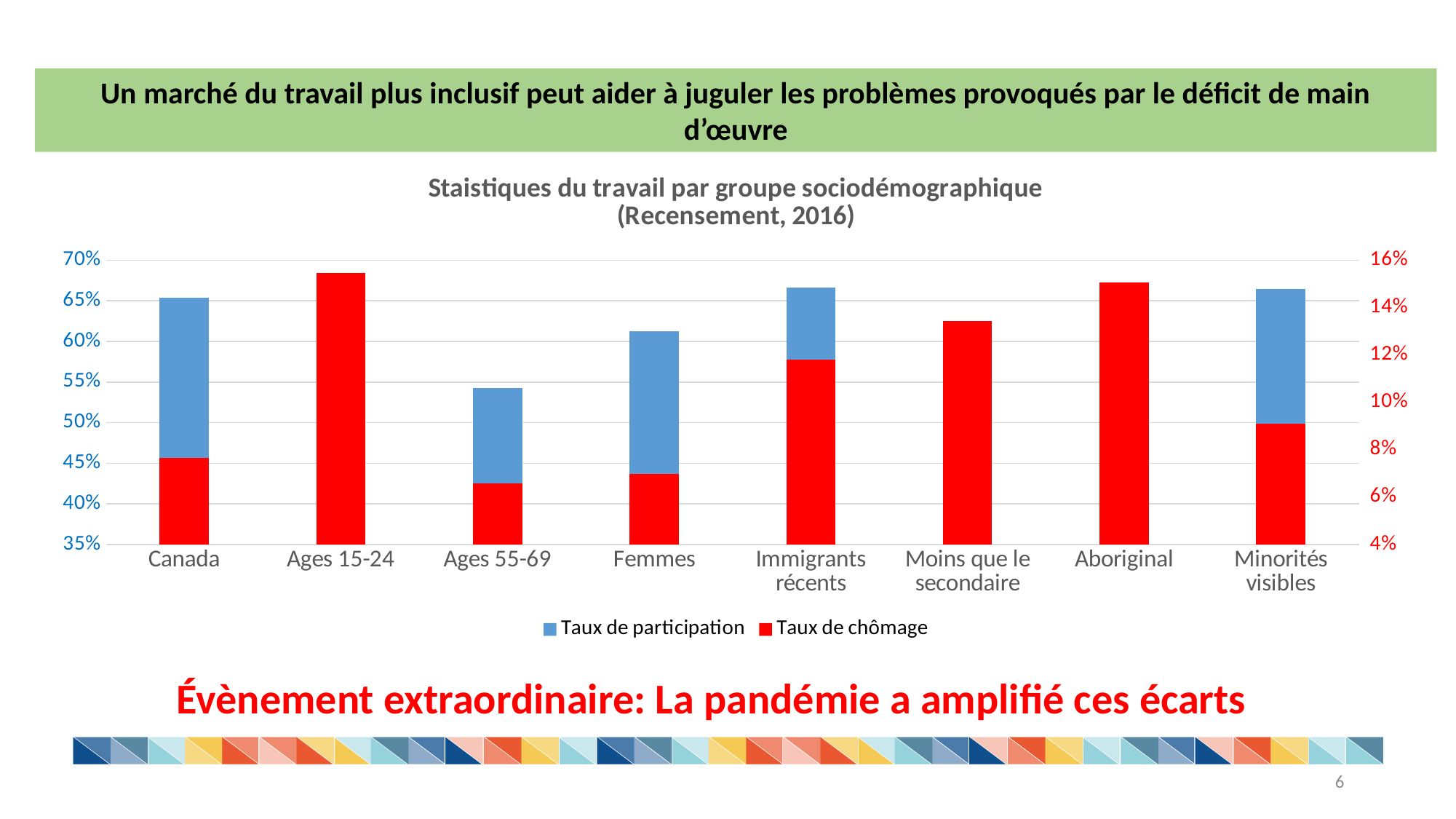
Is the Taux de chômage value for Minorités visibles greater or less than 10%? less Is the Taux de chômage value for Ages 15-24 greater or less than 14%? greater How many series does the chart's legend list? 2 Is the Taux de participation value for Ages 55-69 greater or less than 60%? less Which has the larger Taux de participation, Femmes or Ages 55-69? Femmes What kind of chart is shown on the slide? bar chart How many sociodemographic groups are shown on the x axis of the chart? 8 Which series is shown in red in the chart? Taux de chômage What is the title of the chart? Staistiques du travail par groupe sociodémographique (Recensement, 2016) Which has the larger Taux de chômage, Moins que le secondaire or Immigrants récents? Moins que le secondaire